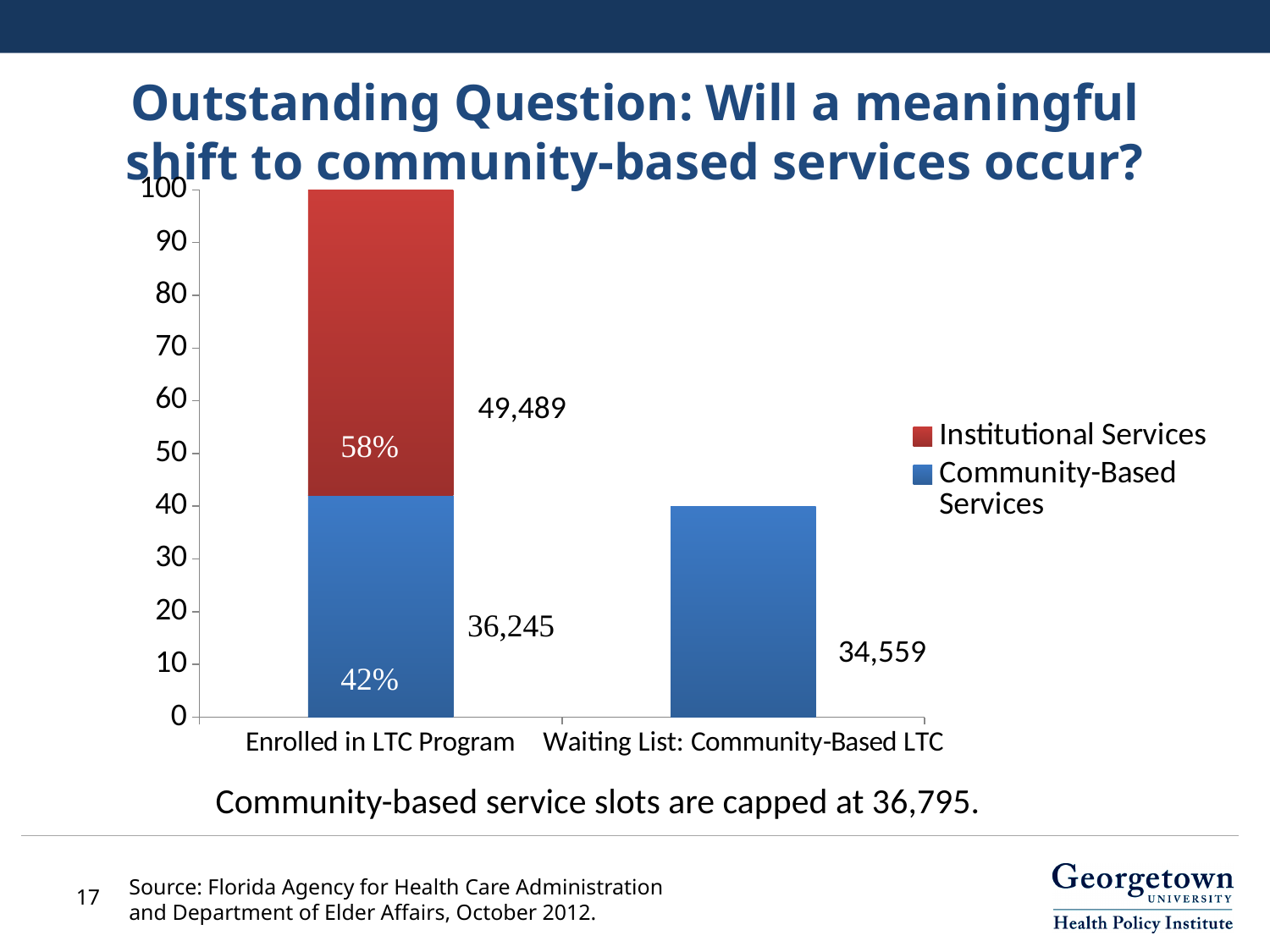
Which category has the taller bar overall? Enrolled in LTC Program What percentage of the Enrolled in LTC Program bar is Institutional Services? 58% How many categories are shown on the x axis? 2 What colour represents Institutional Services in the legend? Red What kind of chart is shown on the slide? Stacked bar chart What is the difference in percentage points between Institutional Services and Community-Based Services in the Enrolled in LTC Program bar? 16 percentage points What is the total of the Enrolled in LTC Program stacked bar? 100% Is the value for Waiting List: Community-Based LTC greater or less than 50? less What number is printed next to the Waiting List: Community-Based LTC bar? 34,559 What percentage of the Enrolled in LTC Program bar is Community-Based Services? 42% How many series does the legend list? 2 In the Enrolled in LTC Program bar, which is larger: Institutional Services or Community-Based Services? Institutional Services